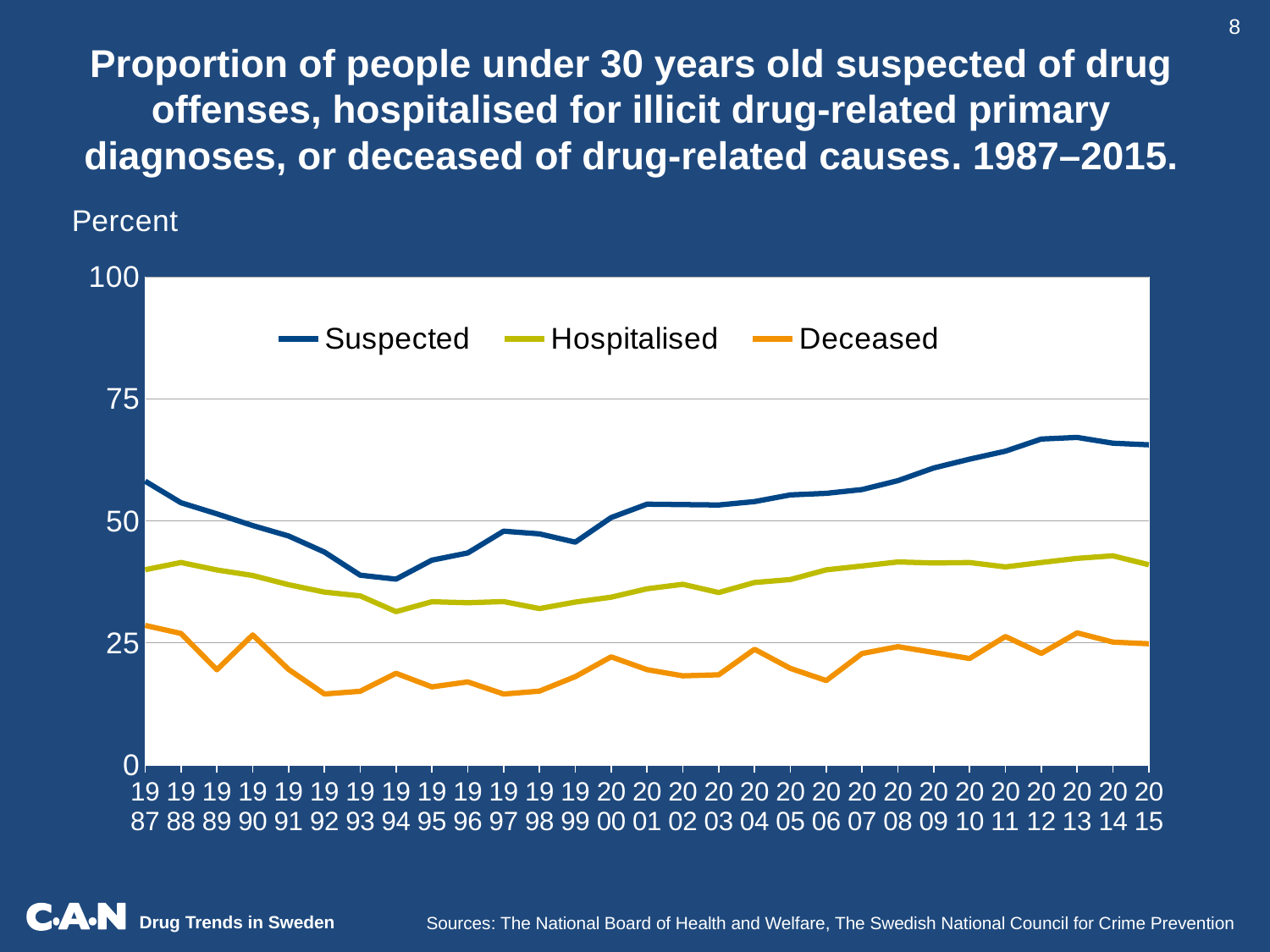
Which series has the lowest value in 2015? Deceased Is the value for Deceased in 1992 greater or less than 25? less How many series does the legend list? 3 Which is larger in 2015, the value for Suspected or the value for Hospitalised? Suspected What label is shown on the y axis of the chart? Percent Does the Suspected series rise or fall between 2000 and 2012? rise Is the value for Suspected in 1994 greater or less than 50? less Which series has the highest value in 2015? Suspected Is the value for Suspected in 2015 greater or less than 50? greater How many years are plotted along the x axis? 29 What kind of chart is shown on the slide? line chart